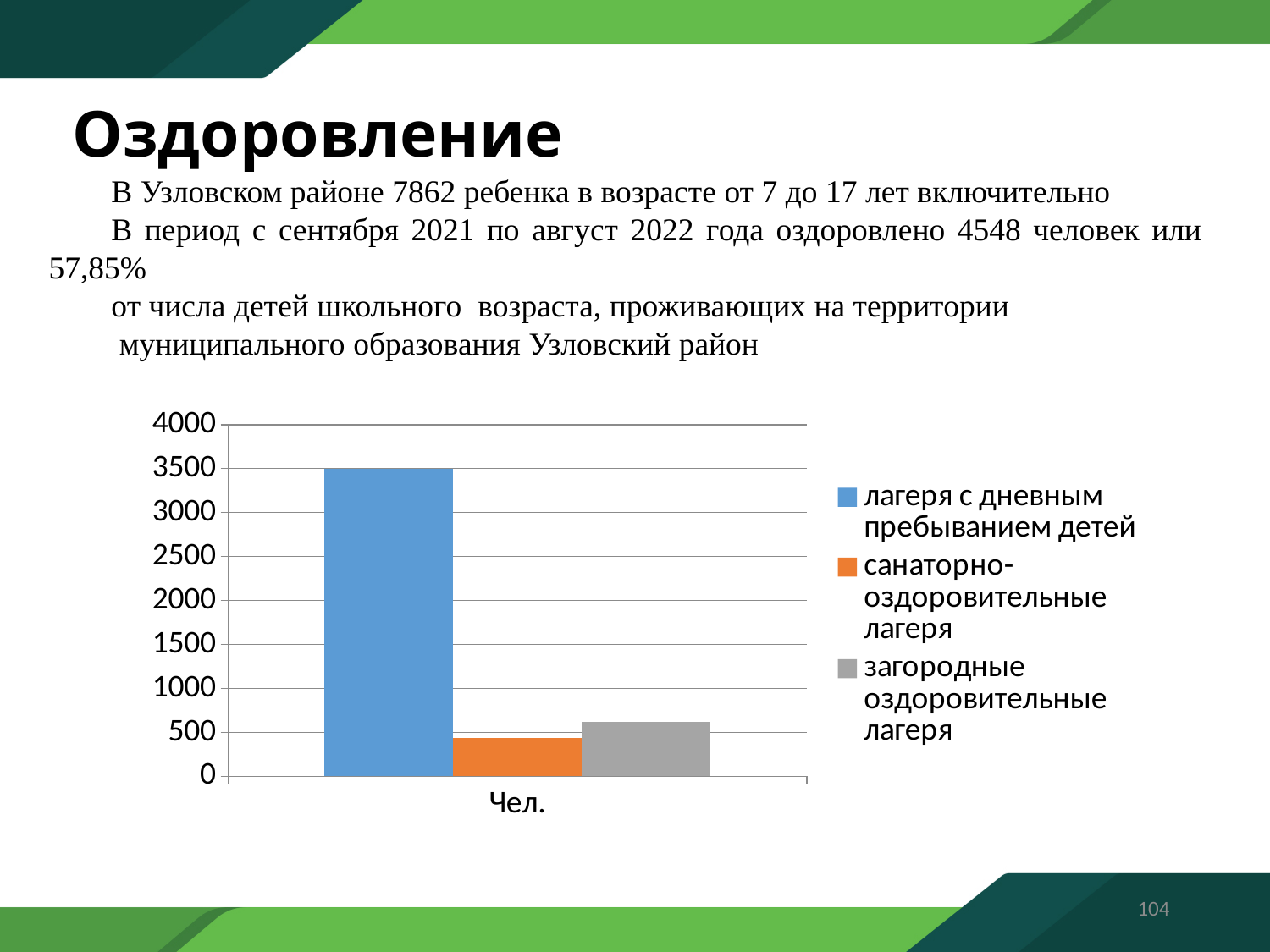
How many categories are shown on the x axis of the chart? 1 How many series does the legend list? 3 Is the value for санаторно-оздоровительные лагеря greater or less than 500? less What kind of chart is shown on the slide? bar chart Is the value for лагеря с дневным пребыванием детей greater or less than 3000? greater Is the value for загородные оздоровительные лагеря greater or less than 500? greater Which series has the lowest value in the chart? санаторно-оздоровительные лагеря Which series has the highest value in the chart? лагеря с дневным пребыванием детей Which colour represents лагеря с дневным пребыванием детей in the chart? blue What is the label of the category on the x axis of the chart? Чел. Which is larger: the value for загородные оздоровительные лагеря or the value for санаторно-оздоровительные лагеря? загородные оздоровительные лагеря